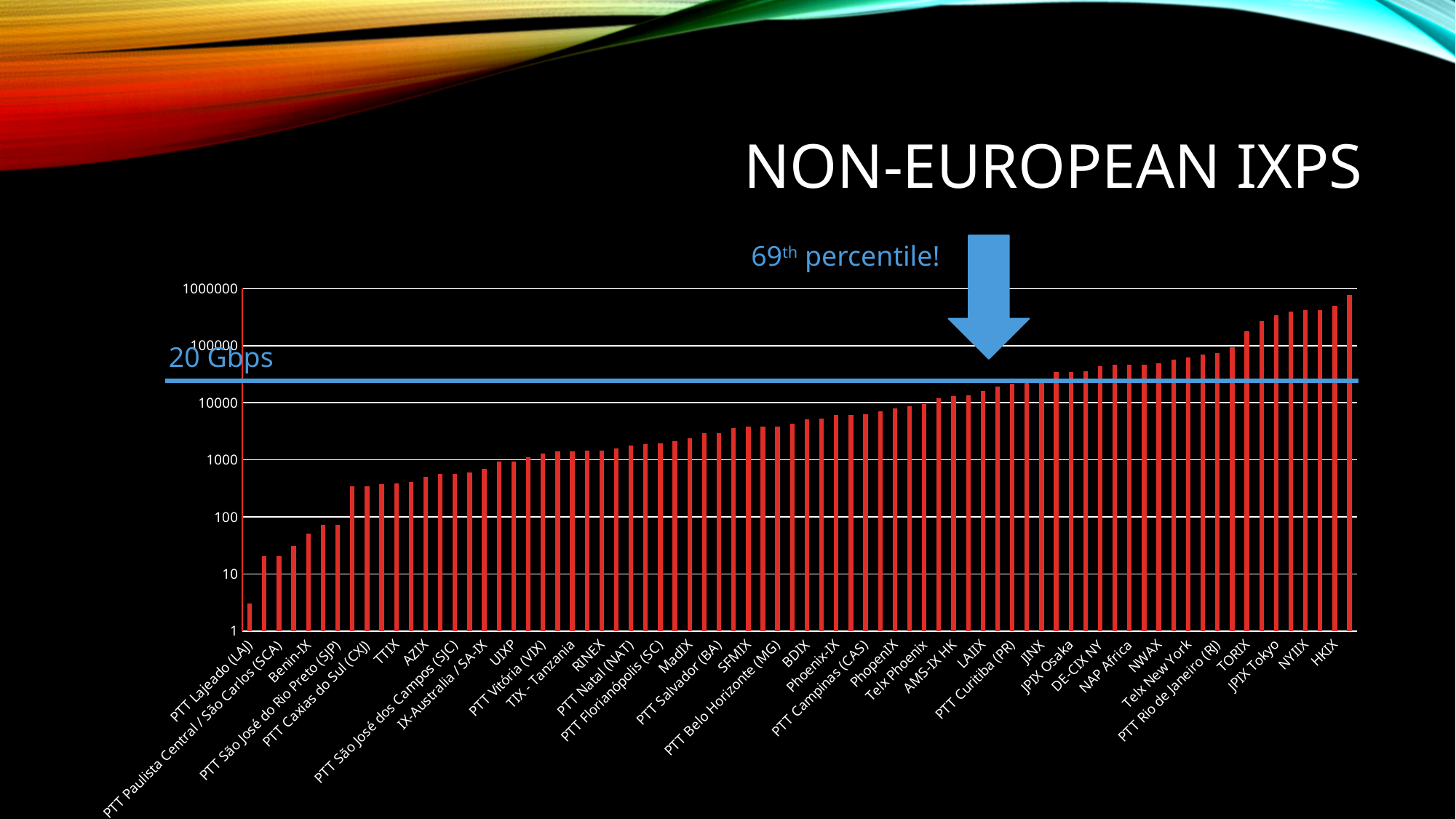
Is the value for BDIX greater or less than 10000? less What value is labelled on the horizontal blue line drawn across the chart? 20 Gbps What kind of chart is shown on the slide? bar chart Is the value for TORIX greater or less than 100000? greater Is the value for Benin-IX greater or less than 100? less Which IXP has the lowest value in the chart? PTT Lajeado (LAJ) Which has the larger value, TORIX or TTIX? TORIX Do the bar values rise or fall from left to right along the x axis? rise